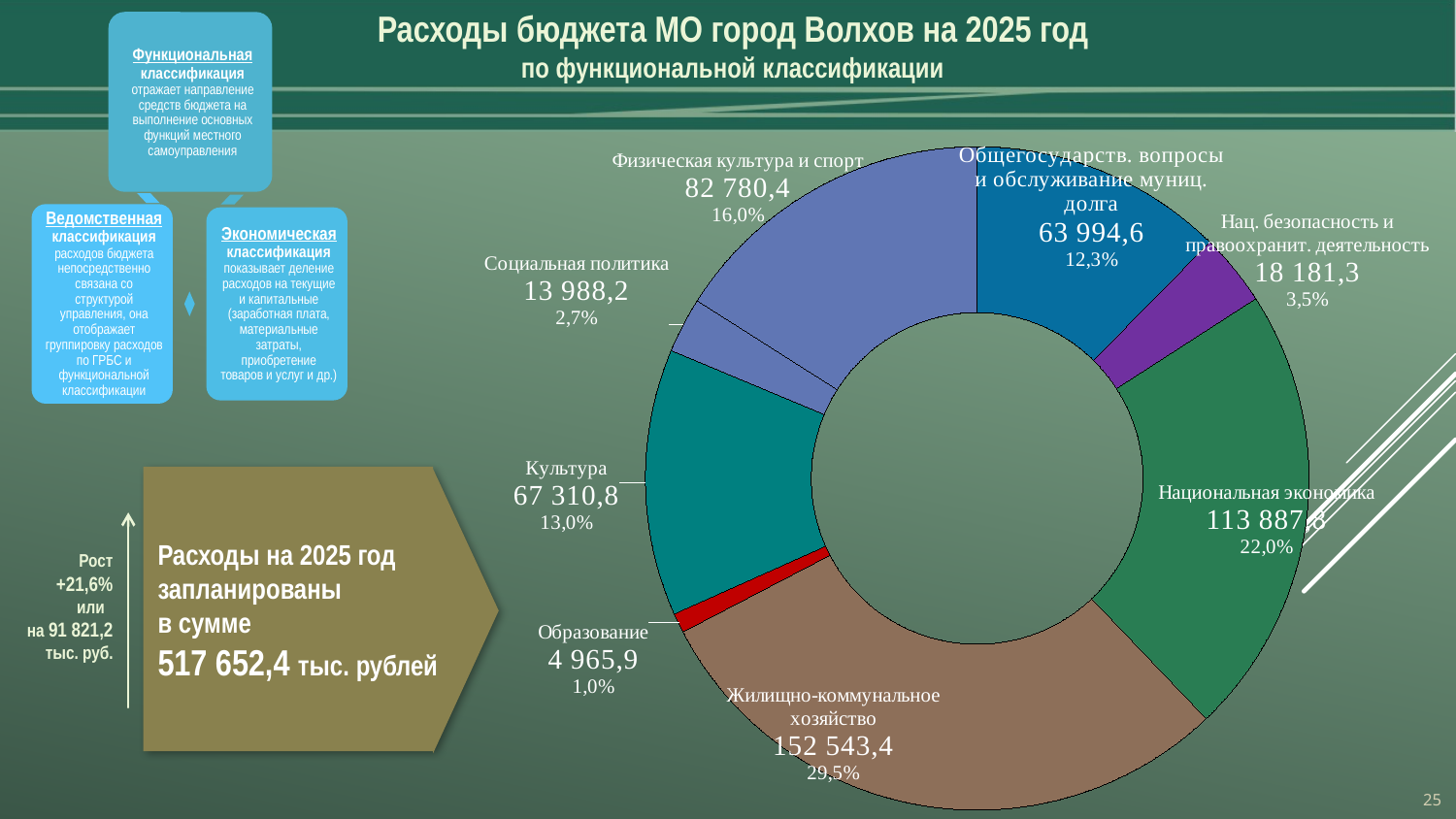
What is the difference between the values for Физическая культура и спорт and Культура? 15 469,6 Which category has the smallest share of the pie? Образование How many categories does the pie chart show? 8 Which is larger: Физическая культура и спорт or Общегосударств. вопросы и обслуживание муниц. долга? Физическая культура и спорт What share of the pie does Социальная политика represent? 2,7% What is the value for Жилищно-коммунальное хозяйство? 152 543,4 What is the value for Культура? 67 310,8 What kind of chart is shown on the slide? Pie (doughnut) chart What is the value for Образование? 4 965,9 Which category has the largest share of the pie? Жилищно-коммунальное хозяйство What is the value for Нац. безопасность и правоохранит. деятельность? 18 181,3 What share of the pie does Национальная экономика represent? 22,0%